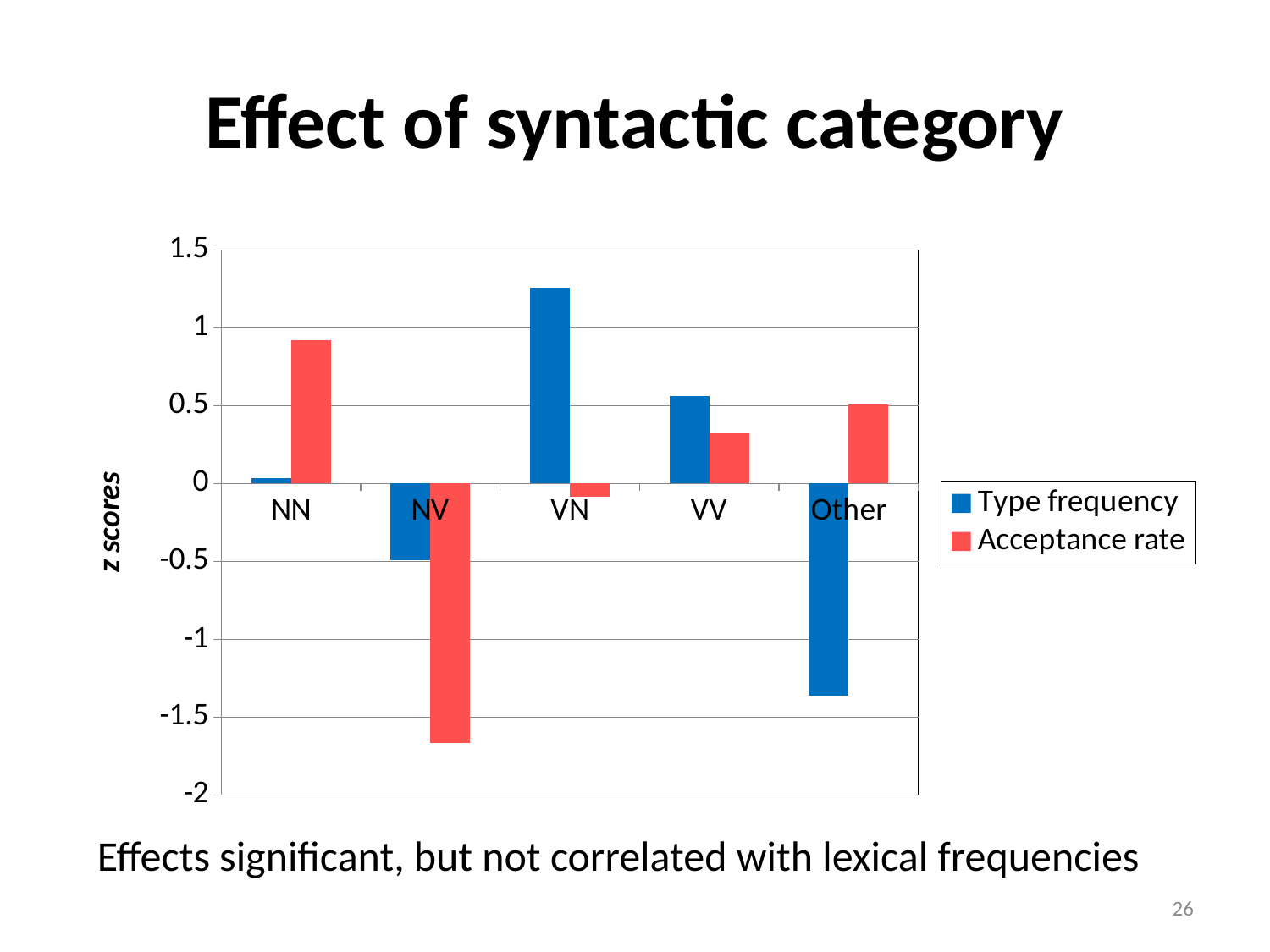
Which category has the lowest Acceptance rate z score? NV Which category has the highest Type frequency z score? VN How many series does the legend list? 2 Is the Type frequency value for Other greater or less than -1? less How many categories are shown on the x axis? 5 Is the Acceptance rate value for NV greater or less than -1.5? less What is the label on the vertical axis? z scores Which category has the highest Acceptance rate z score? NN What kind of chart is shown on the slide? bar chart For NN, which is larger: Type frequency or Acceptance rate? Acceptance rate Is the Type frequency value for VN greater or less than 1? greater Which category has the lowest Type frequency z score? Other